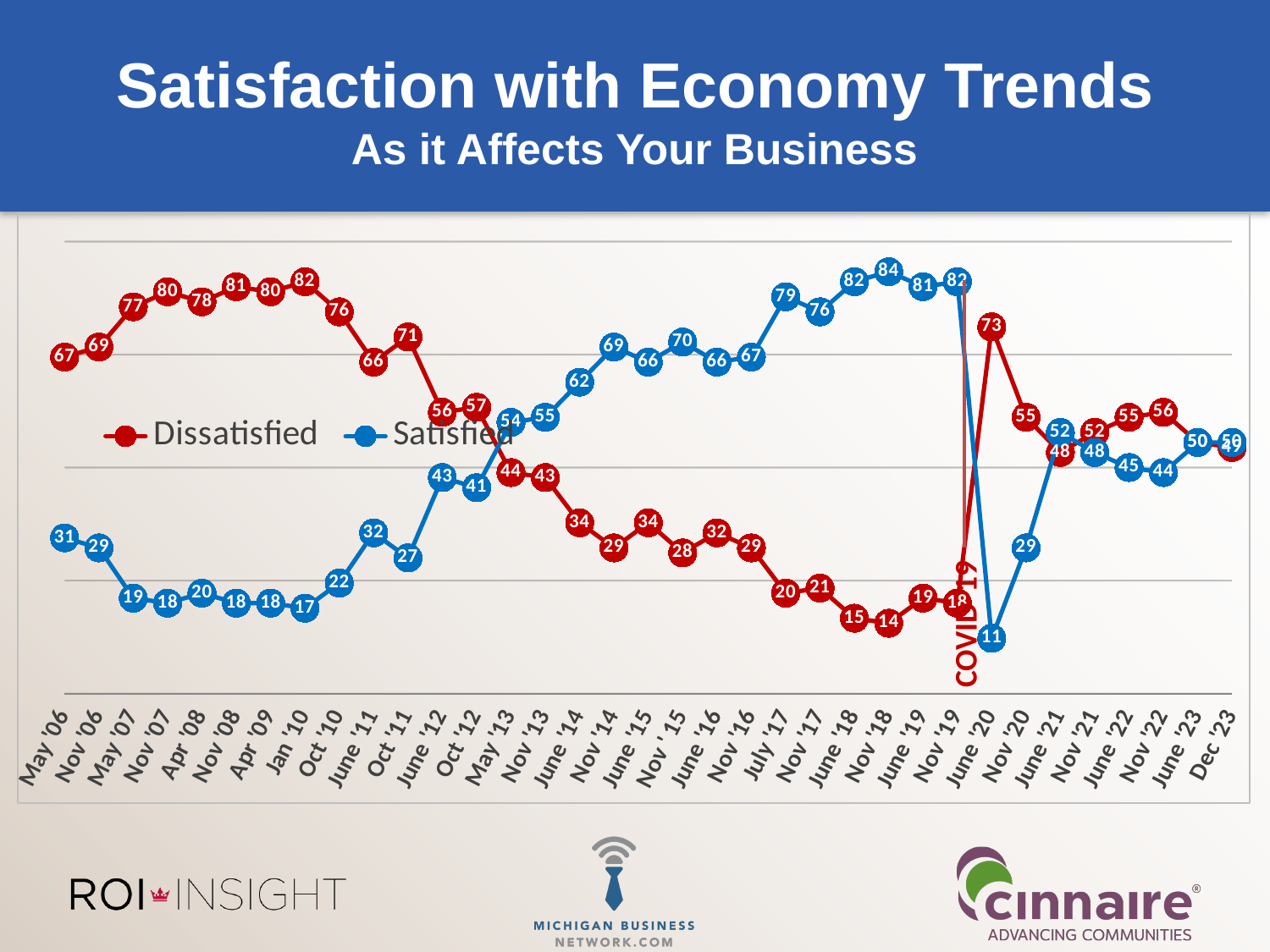
What is the difference between the Dissatisfied and Satisfied values in June '20? 62 What annotation is written vertically near the Nov '19 to June '20 points? COVID-19 In Nov '18, which series has the larger value, Satisfied or Dissatisfied? Satisfied What is the Satisfied value for Nov '18? 84 How many series does the legend list? 2 What kind of chart is shown on the slide? line chart What is the Satisfied value for June '20? 11 In which period is the Satisfied series at its highest? Nov '18 What is the Dissatisfied value for June '20? 73 In which period is the Dissatisfied series at its highest? Jan '10 In which period is the Satisfied series at its lowest? June '20 Does the Dissatisfied series rise or fall from Jan '10 to Nov '18? fall